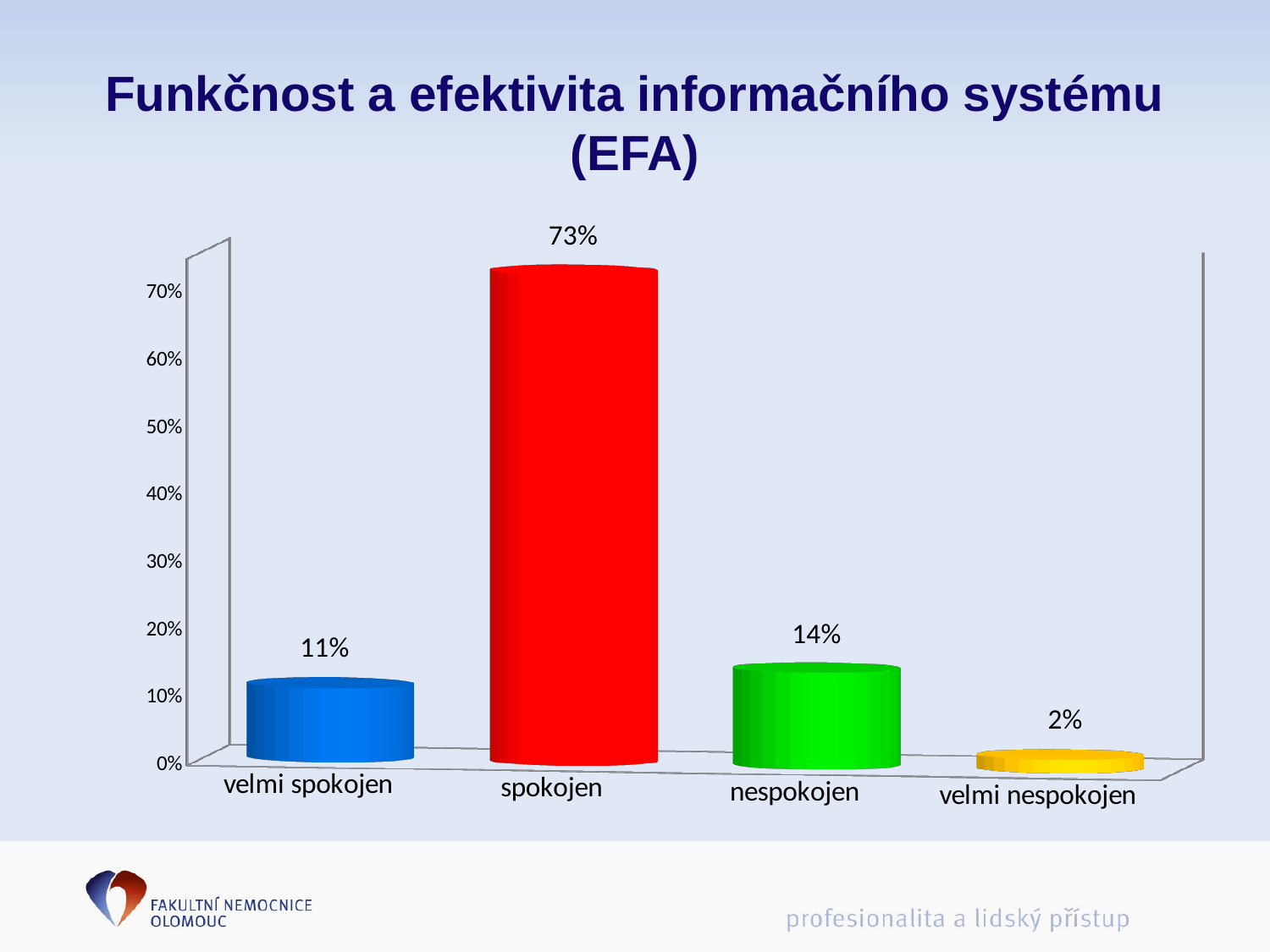
Which is larger, the value for "nespokojen" or the value for "velmi spokojen"? nespokojen What is the difference between the values for "spokojen" and "nespokojen"? 59% What is the value for "velmi nespokojen"? 2% What is the value for "velmi spokojen"? 11% What kind of chart is shown on the slide? bar chart Which category has the highest value? spokojen What is the title of the slide? Funkčnost a efektivita informačního systému (EFA) What is the value for "spokojen"? 73% What is the value for "nespokojen"? 14% What is the difference between the values for "nespokojen" and "velmi spokojen"? 3% How many categories are shown on the x axis? 4 Which category has the lowest value? velmi nespokojen